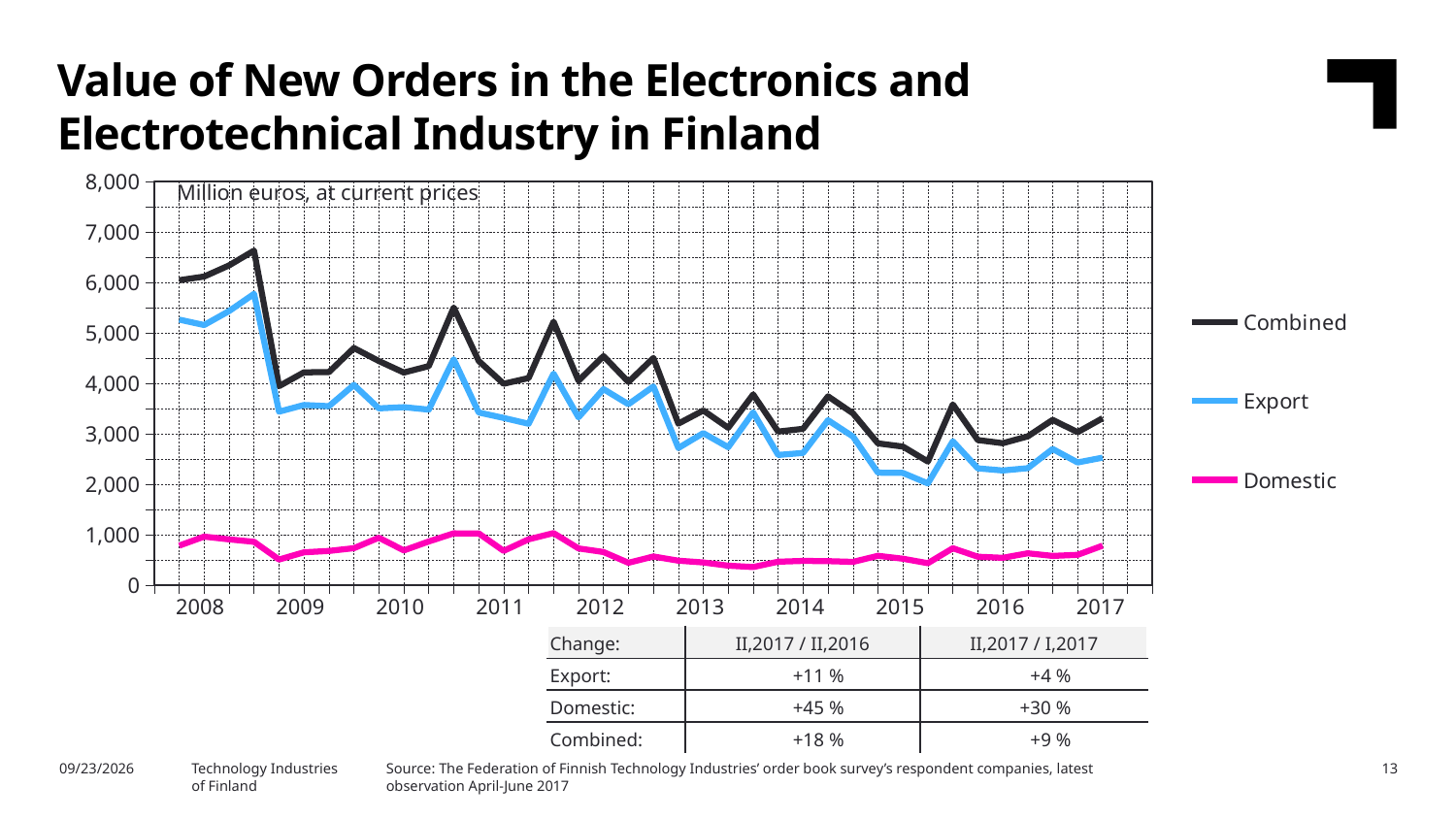
Is the peak value of the Combined series in 2008 greater or less than 6,000? greater Which series is plotted with the lowest values throughout the chart? Domestic Overall, do the Combined values rise or fall from 2008 to 2017? fall In 2016, which is larger, the Export value or the Domestic value? Export Is the value for Export at the start of 2008 greater or less than 5,000? greater Is the value for Combined at the end of 2017 greater or less than 3,000? greater How many year labels are shown on the x axis? 10 In what unit are the values on the chart expressed? Million euros, at current prices Which series is plotted with the highest values throughout the chart? Combined What kind of chart is shown on the slide? line chart How many series does the legend list? 3